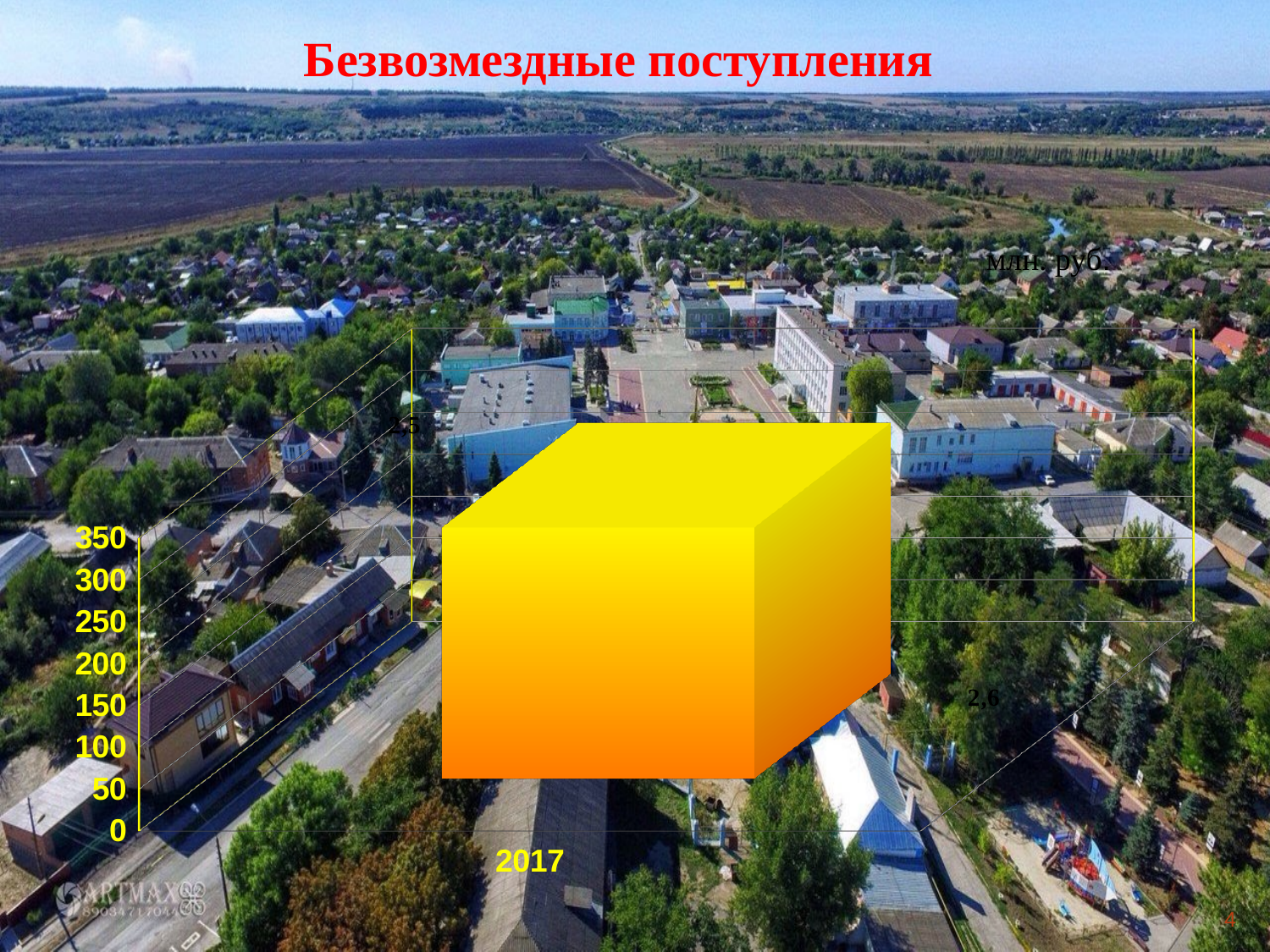
How many bars (categories) does the chart show? 1 What unit is indicated for the values in the chart? млн. руб. Is the value for 2017 greater or less than 100? greater Is the value for 2017 greater or less than 200? greater What is the title of the chart on the slide? Безвозмездные поступления Which year is labelled on the x axis of the chart? 2017 What is the lowest tick value shown on the vertical axis of the chart? 0 What is the highest tick value shown on the vertical axis of the chart? 350 What kind of chart is shown on the slide? bar chart